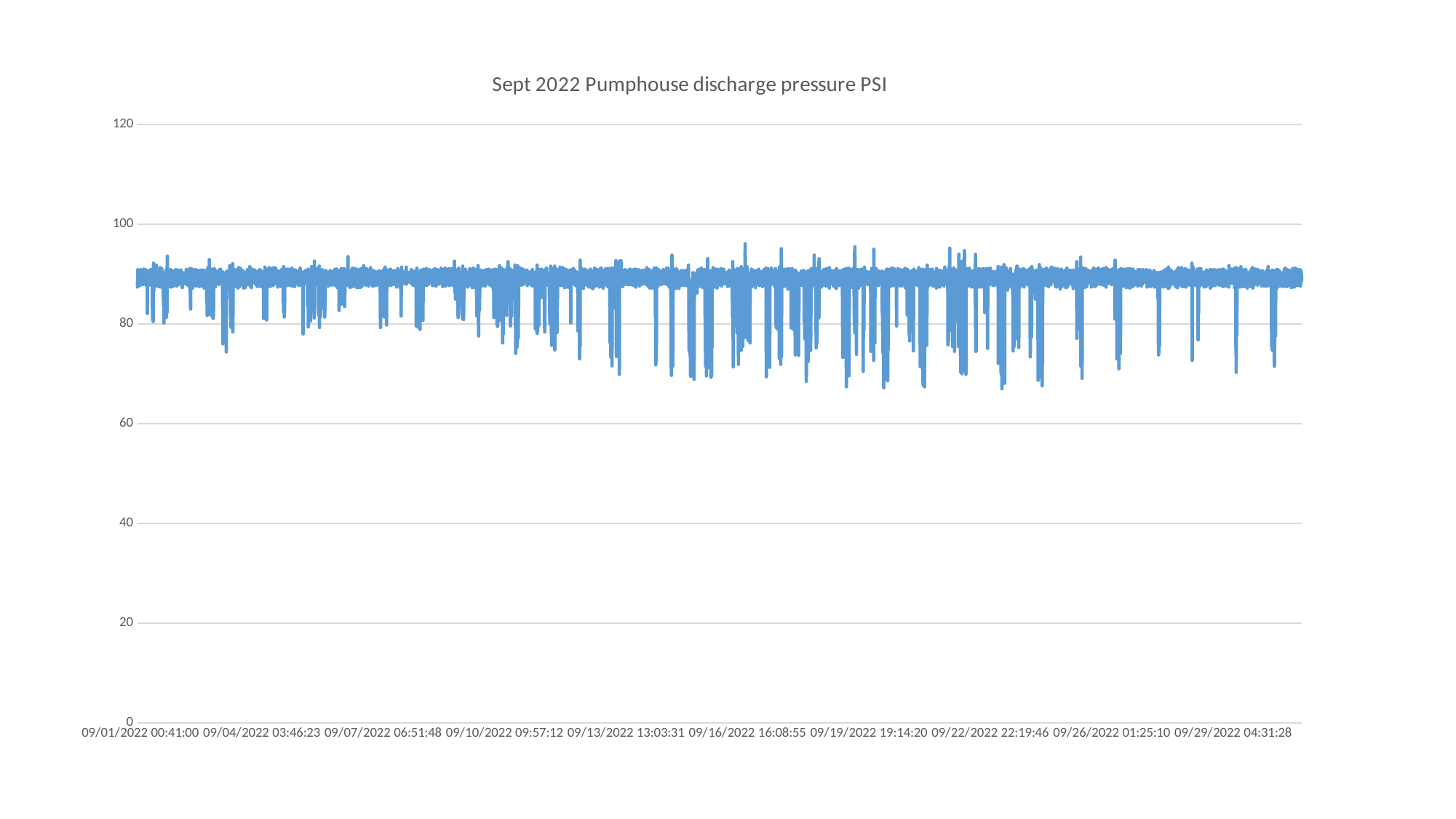
Does the baseline level of the series rise, fall, or stay roughly flat across the month? roughly flat Is the lowest dip in the series greater or less than 80? less Is the value at the end of the series (09/29/2022) greater or less than 80? greater How many date labels are shown along the x axis? 10 Is the typical value of the series greater or less than 100? less What kind of chart is shown on the slide? line chart What is the title of the chart? Sept 2022 Pumphouse discharge pressure PSI What is the highest value shown on the y axis? 120